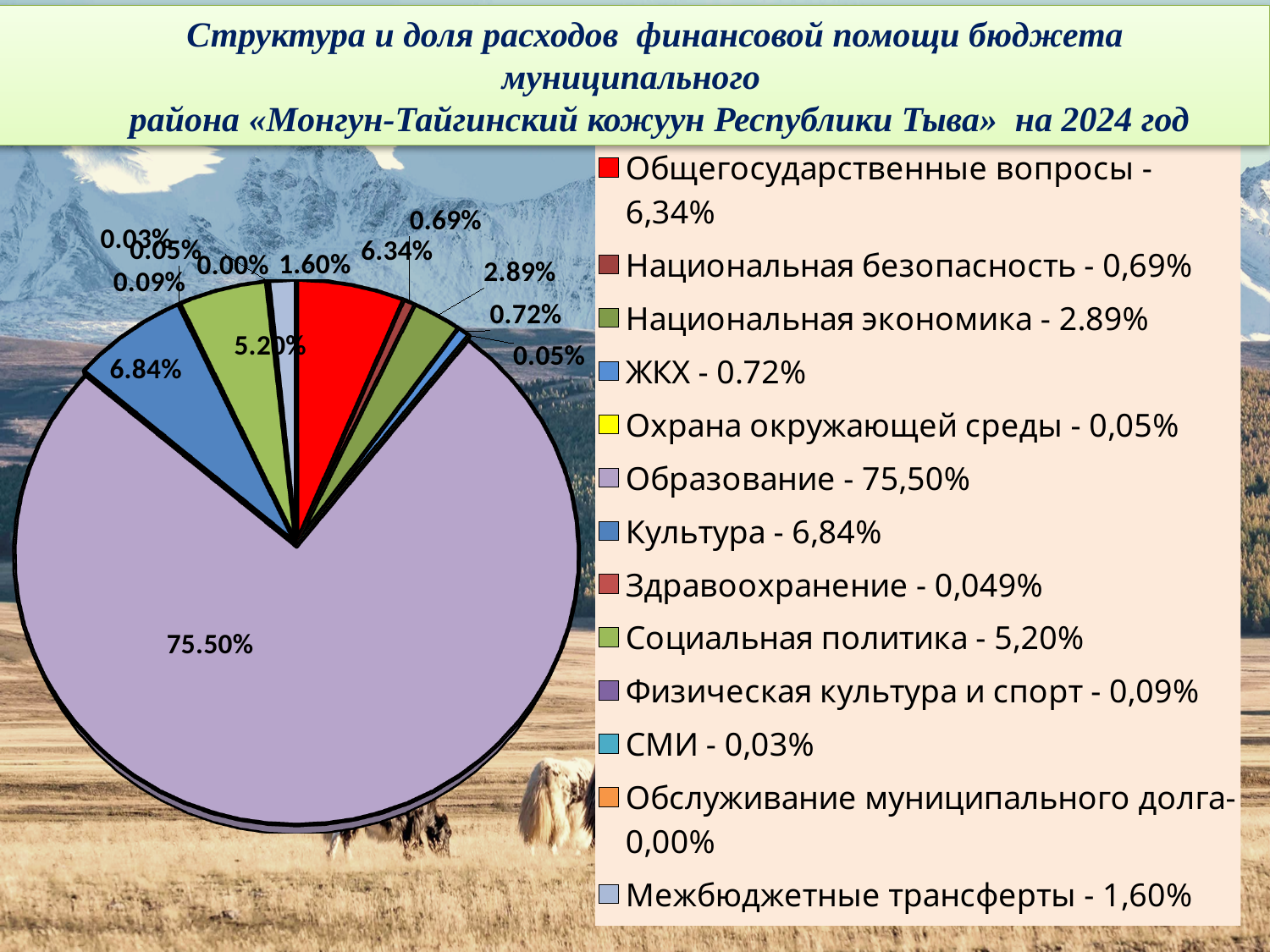
What is the difference between the values for Образование and Культура? 68,66% What is the value for Культура? 6,84% What kind of chart is shown on the slide? pie chart What is the value for Национальная экономика? 2.89% Which category has the smallest value in the legend? Обслуживание муниципального долга What is the value for Межбюджетные трансферты? 1,60% How many categories does the legend list? 13 What is the value for Социальная политика? 5,20% Which category has the largest share of the pie? Образование What is the value for Общегосударственные вопросы? 6,34% What share of the pie does Образование have? 75,50% Which is larger, Культура or Общегосударственные вопросы? Культура